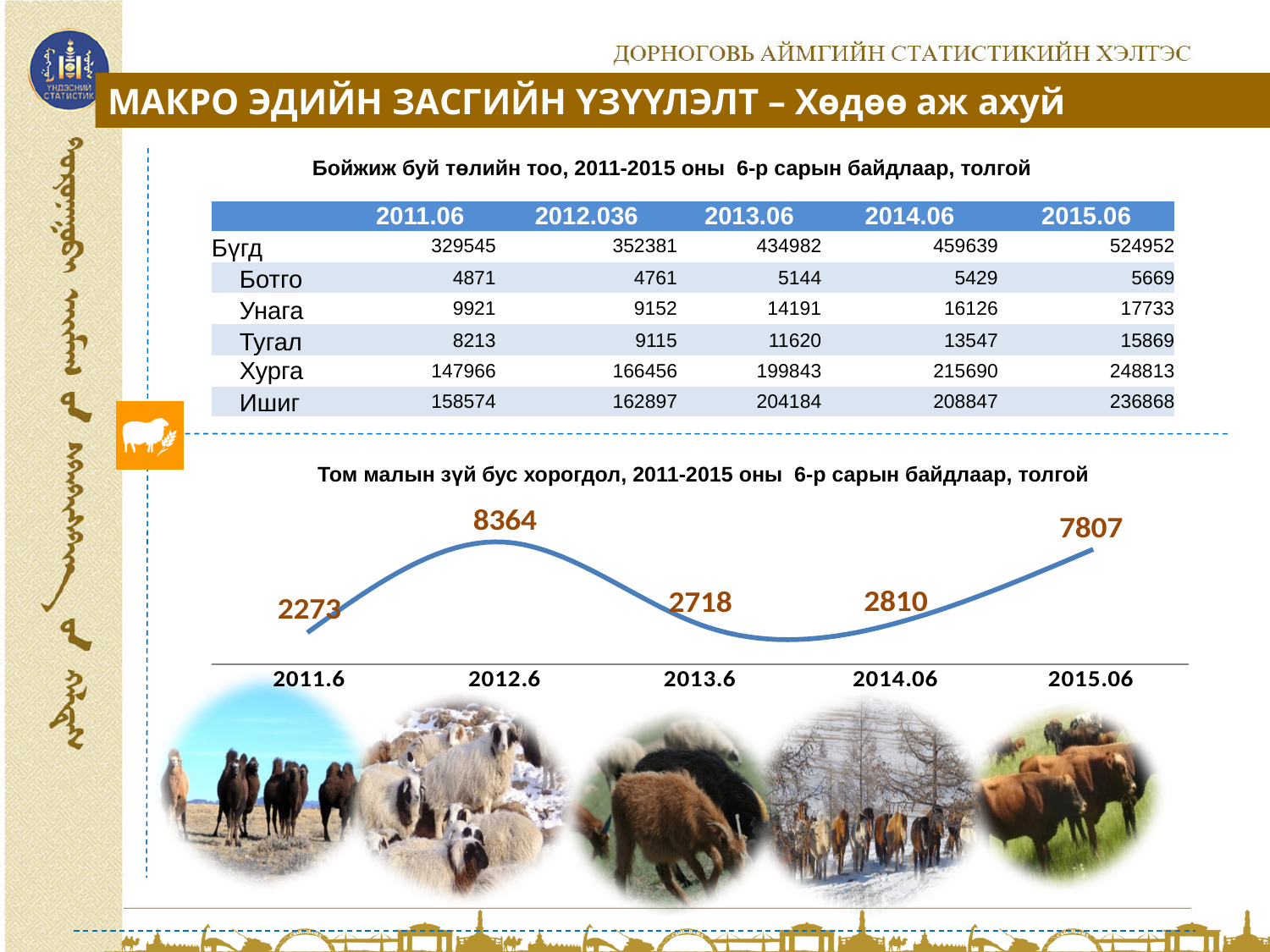
In the line chart, which is larger: the value for 2012.6 or the value for 2015.06? 2012.6 In the line chart, what is the value for 2012.6? 8364 In the line chart, what is the value for 2014.06? 2810 In the line chart, which year has the highest value? 2012.6 In the line chart, what is the difference between the values for 2014.06 and 2013.6? 92 In the line chart, what is the difference between the values for 2012.6 and 2015.06? 557 How many data points are plotted in the line chart? 5 In the line chart, what is the value for 2013.6? 2718 In the line chart, what is the value for 2015.06? 7807 In the line chart, what is the value for 2011.6? 2273 What type of chart is shown below the table on the slide? Line chart In the line chart, which year has the lowest value? 2011.6